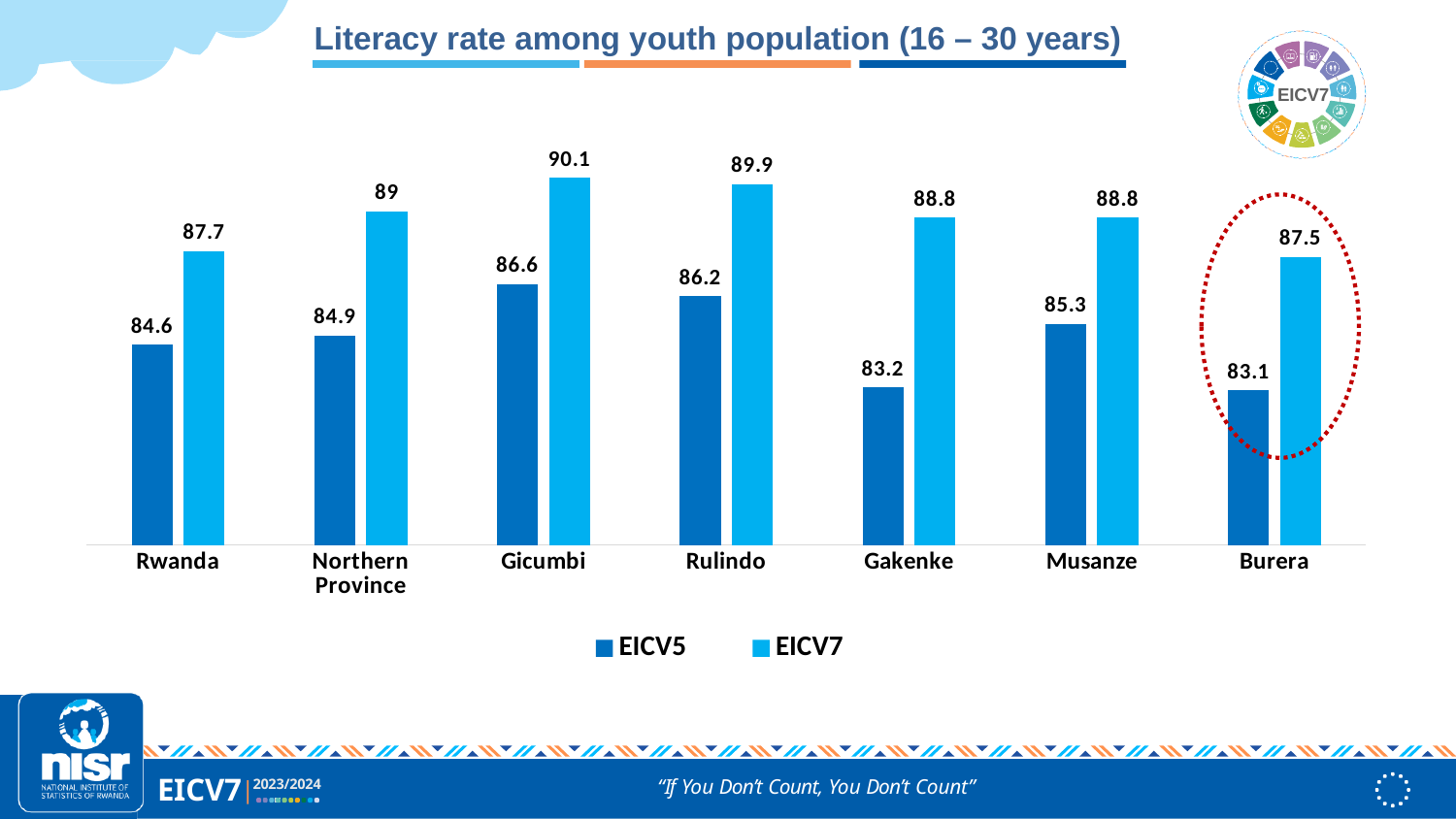
Which category has the lowest EICV7 literacy rate? Burera What is the EICV5 literacy rate for Burera? 83.1 How many series does the legend list? 2 What kind of chart is shown on the slide? Bar chart How many categories are shown on the x axis? 7 What is the EICV5 value for Musanze? 85.3 What is the difference between the EICV7 and EICV5 values for Burera? 4.4 What is the EICV7 value for Northern Province? 89 What is the difference between the EICV7 and EICV5 values for Gakenke? 5.6 What is the EICV7 literacy rate for Gicumbi? 90.1 Which category has the highest EICV7 literacy rate? Gicumbi Which is larger for Rulindo, the EICV5 value or the EICV7 value? EICV7